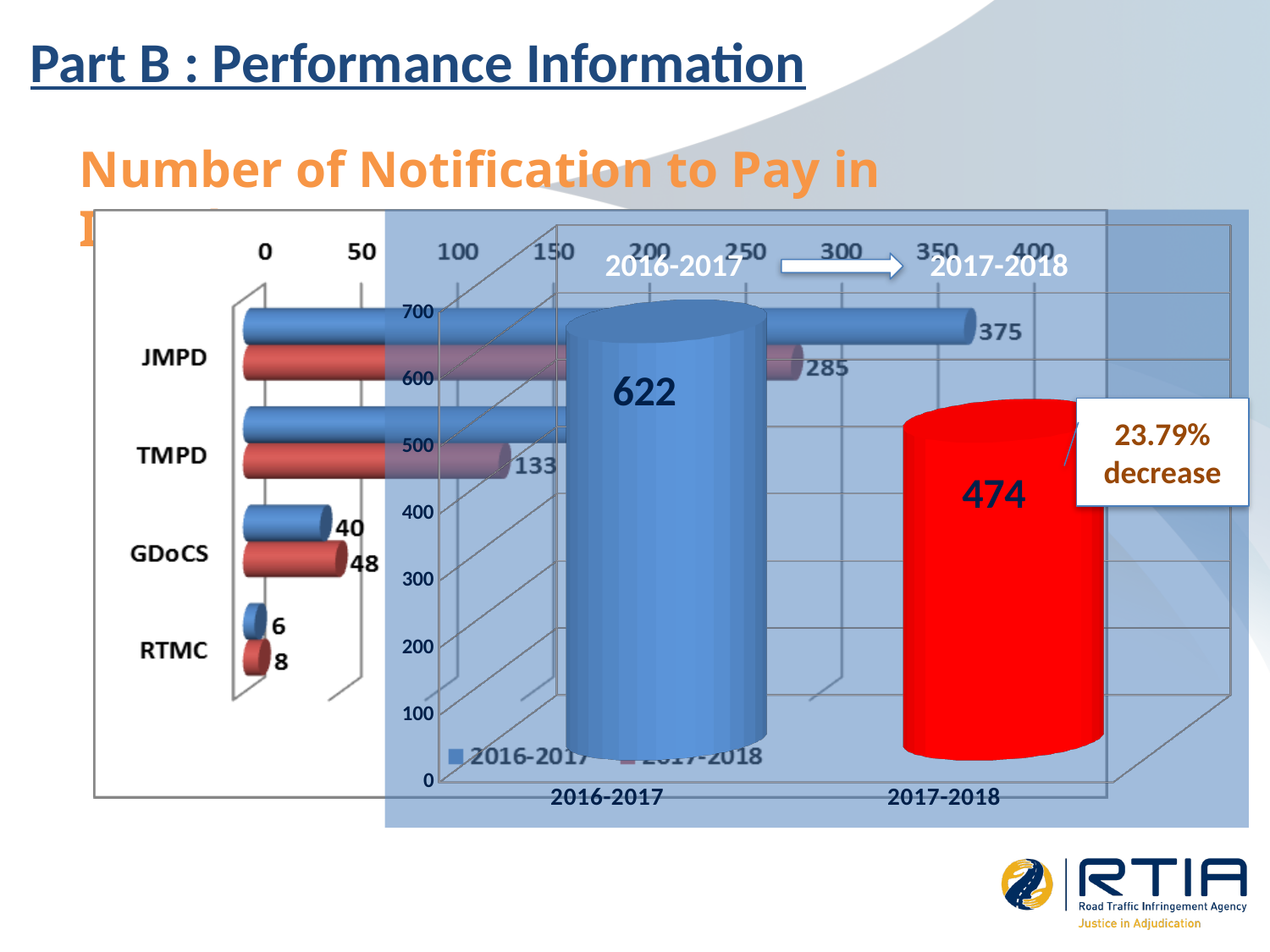
In the vertical bar chart on the right, what percentage decrease is shown in the callout? 23.79% decrease In the horizontal bar chart on the left, what is the 2017-2018 value for TMPD? 133 In the vertical bar chart on the right, what is the value for 2016-2017? 622 In the horizontal bar chart on the left, what is the 2017-2018 value for GDoCS? 48 In the horizontal bar chart on the left, which category has the lowest 2017-2018 value? RTMC In the vertical bar chart on the right, which year has the higher value, 2016-2017 or 2017-2018? 2016-2017 In the vertical bar chart on the right, what is the value for 2017-2018? 474 In the horizontal bar chart on the left, what is the 2016-2017 value for JMPD? 375 In the horizontal bar chart on the left, what is the 2016-2017 value for RTMC? 6 In the vertical bar chart on the right, what is the difference between the 2016-2017 and 2017-2018 values? 148 In the horizontal bar chart on the left, how many categories are shown on the vertical axis? 4 In the horizontal bar chart on the left, what is the 2017-2018 value for JMPD? 285